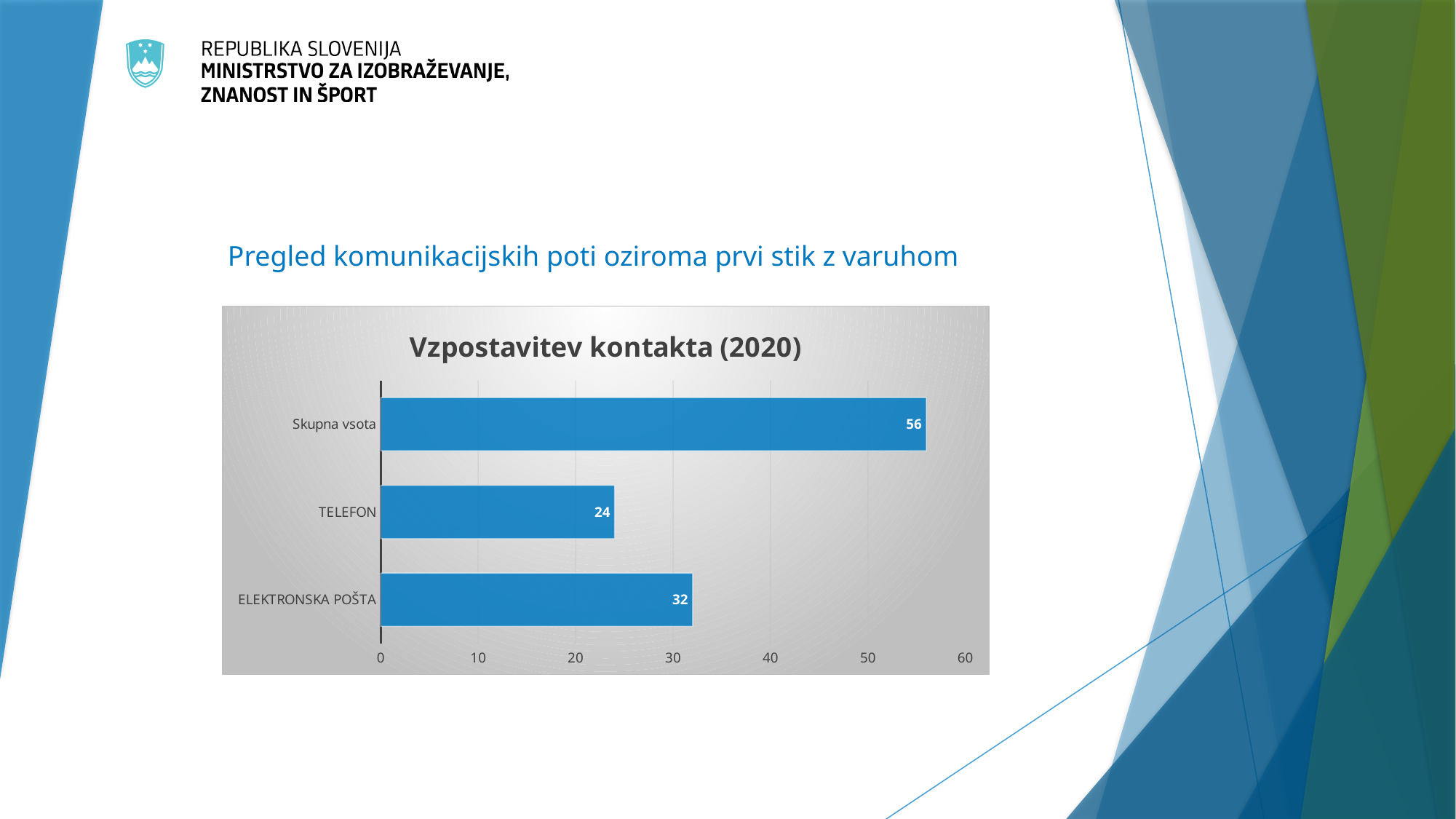
What is the difference between the values for ELEKTRONSKA POŠTA and TELEFON? 8 What is the highest value shown on the horizontal axis? 60 How many categories are shown in the chart? 3 What kind of chart is shown on the slide? bar chart What is the value for Skupna vsota? 56 Which category has the highest value? Skupna vsota Which is larger, the value for ELEKTRONSKA POŠTA or the value for TELEFON? ELEKTRONSKA POŠTA Is the value for Skupna vsota greater or less than 50? greater What is the value for TELEFON? 24 What is the value for ELEKTRONSKA POŠTA? 32 What is the title of the chart? Vzpostavitev kontakta (2020) Which category has the lowest value? TELEFON